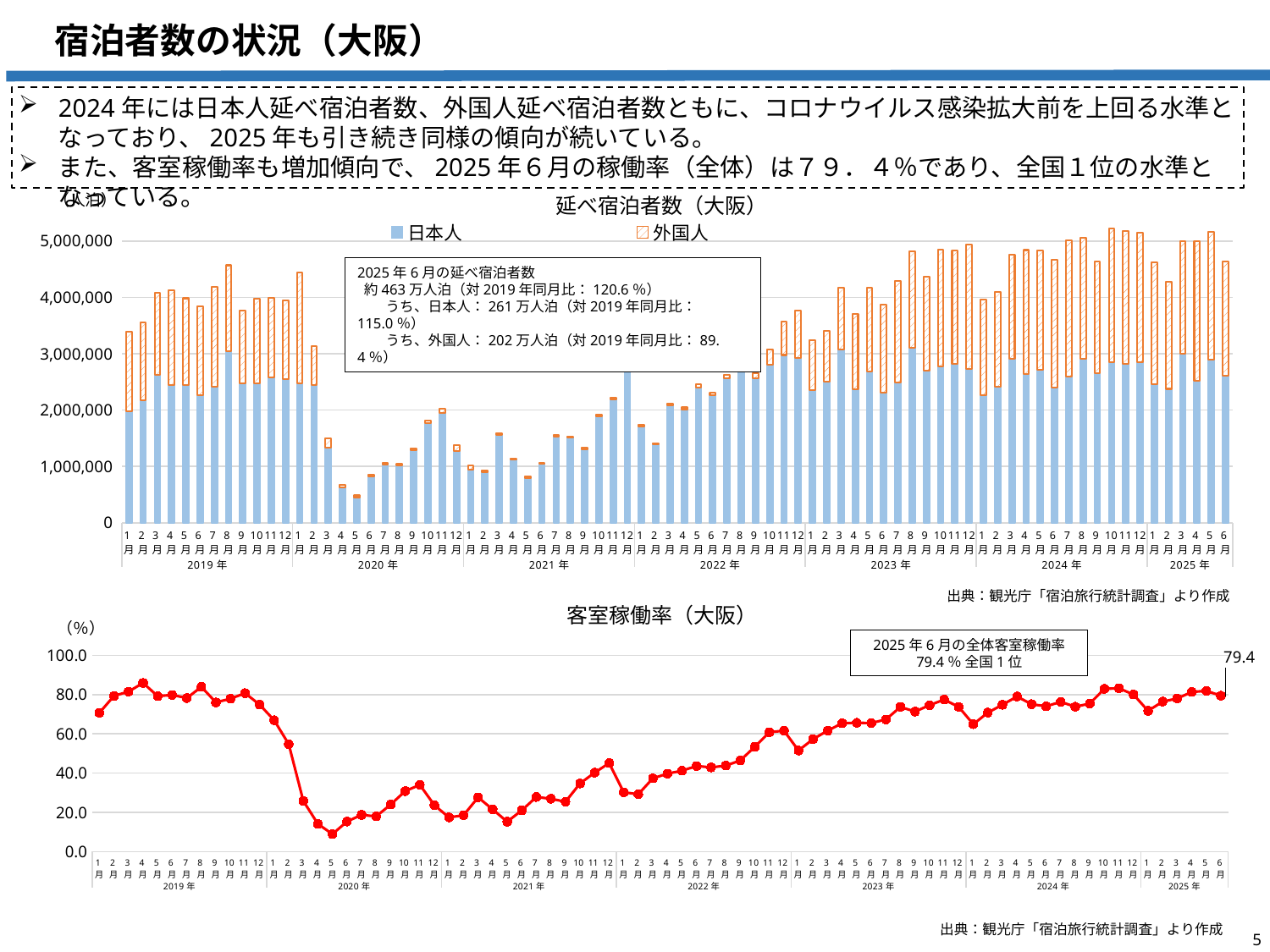
What kind of chart is the bottom chart titled 客室稼働率（大阪）? line chart In the bottom chart 客室稼働率（大阪）, how many monthly points are plotted for 2025年? 6 In the bottom chart 客室稼働率（大阪）, which month has the lowest occupancy rate? 2020年5月 In the top chart 延べ宿泊者数（大阪）, what are the two legend entries? 日本人, 外国人 What kind of chart is the top chart titled 延べ宿泊者数（大阪）? bar chart In the top chart 延べ宿泊者数（大阪）, is the total for 2020年5月 greater or less than 1,000,000? less In the bottom chart 客室稼働率（大阪）, is the value for 2020年5月 greater or less than 20.0? less In the top chart 延べ宿泊者数（大阪）, which is larger, the total for 2019年8月 or the total for 2020年8月? 2019年8月 In the bottom chart 客室稼働率（大阪）, what is the value labelled for 2025年6月? 79.4 In the bottom chart 客室稼働率（大阪）, is the value for 2019年4月 greater or less than 80.0? greater In the bottom chart 客室稼働率（大阪）, do the values rise or fall from 2020年1月 to 2020年5月? fall In the top chart 延べ宿泊者数（大阪）, how many series does the legend list? 2